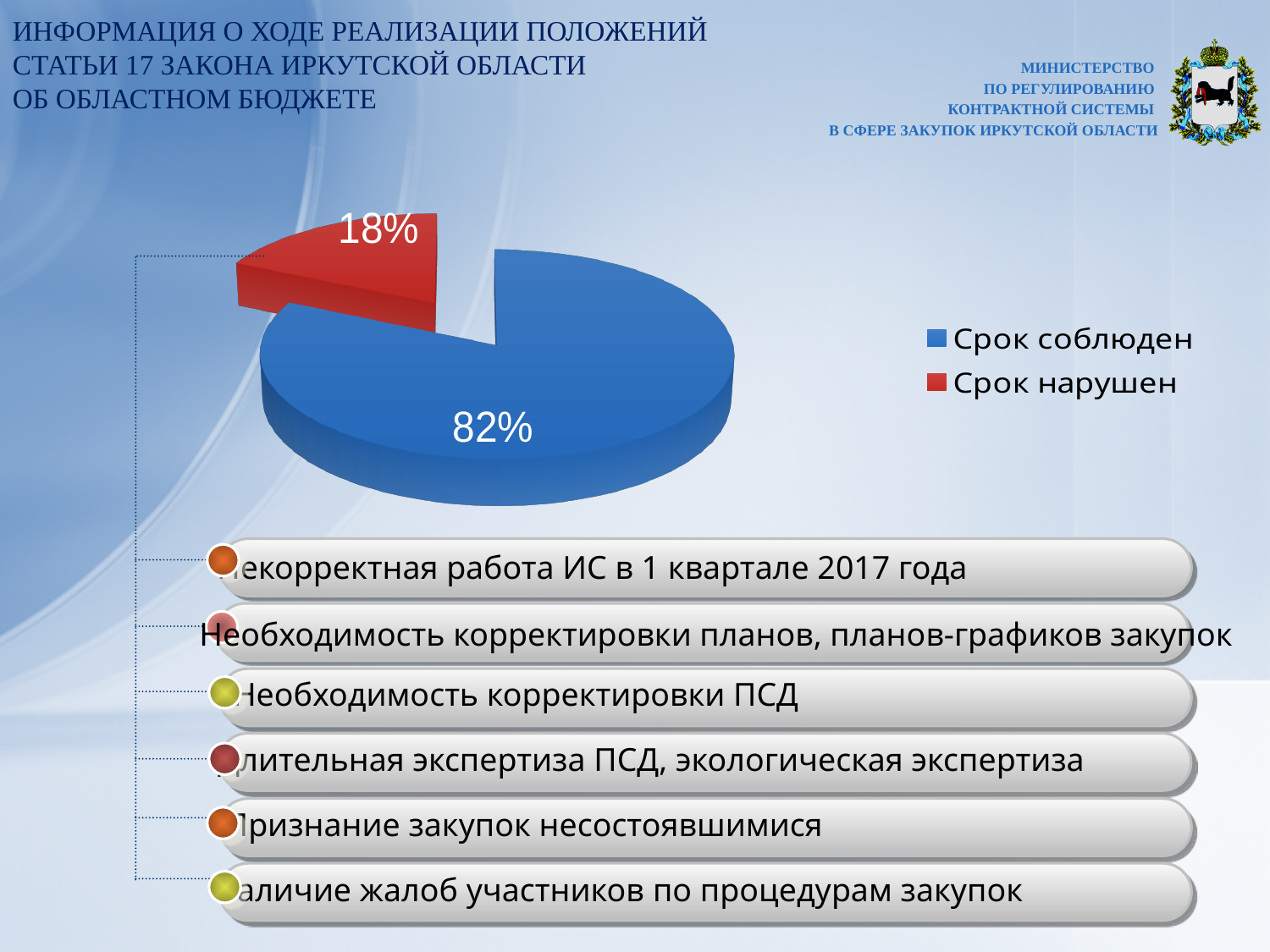
How many slices does the pie chart have? 2 What kind of chart is shown on the slide? pie chart What is the difference in percentage points between "Срок соблюден" and "Срок нарушен"? 64 Which slice of the pie is the largest? Срок соблюден What colour is the "Срок соблюден" slice? blue Which is larger, the share for "Срок соблюден" or for "Срок нарушен"? Срок соблюден What share of the pie does "Срок нарушен" represent? 18% How many entries does the legend list? 2 What colour is the "Срок нарушен" slice? red Which slice of the pie is the smallest? Срок нарушен What share of the pie does "Срок соблюден" represent? 82%